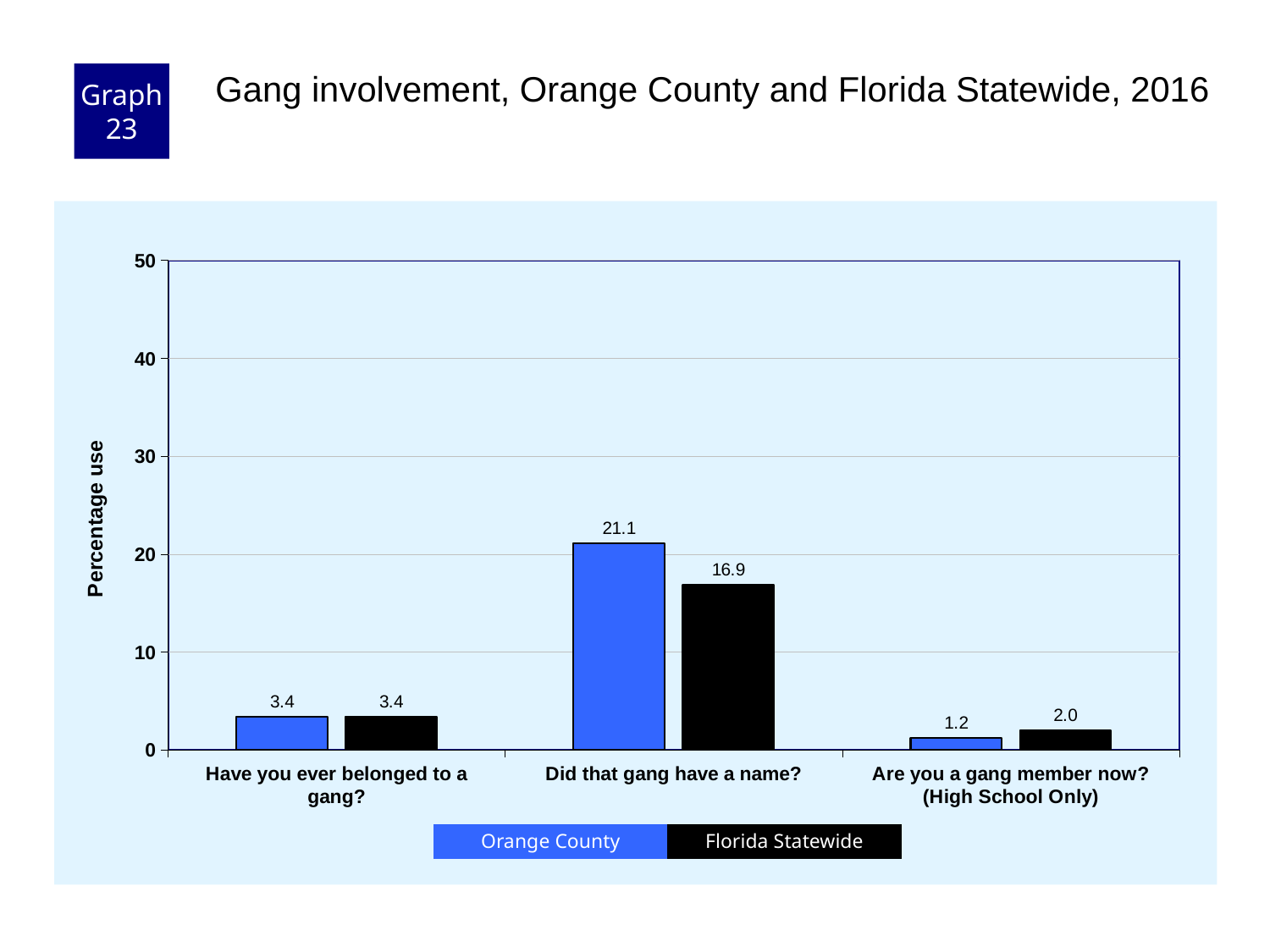
Which question has the highest Orange County value? Did that gang have a name? What is the Orange County value for "Did that gang have a name?"? 21.1 What is the difference between the Orange County and Florida Statewide values for "Did that gang have a name?"? 4.2 What is the label of the y axis? Percentage use How many series does the legend list? 2 How many question categories are shown on the x axis? 3 What kind of chart is shown on the slide? bar chart What is the Florida Statewide value for "Are you a gang member now? (High School Only)"? 2.0 What is the Orange County value for "Have you ever belonged to a gang?"? 3.4 Which question has the lowest Florida Statewide value? Are you a gang member now? (High School Only) For "Are you a gang member now? (High School Only)", which is larger: Orange County or Florida Statewide? Florida Statewide Is the Florida Statewide value for "Did that gang have a name?" greater or less than 20? less